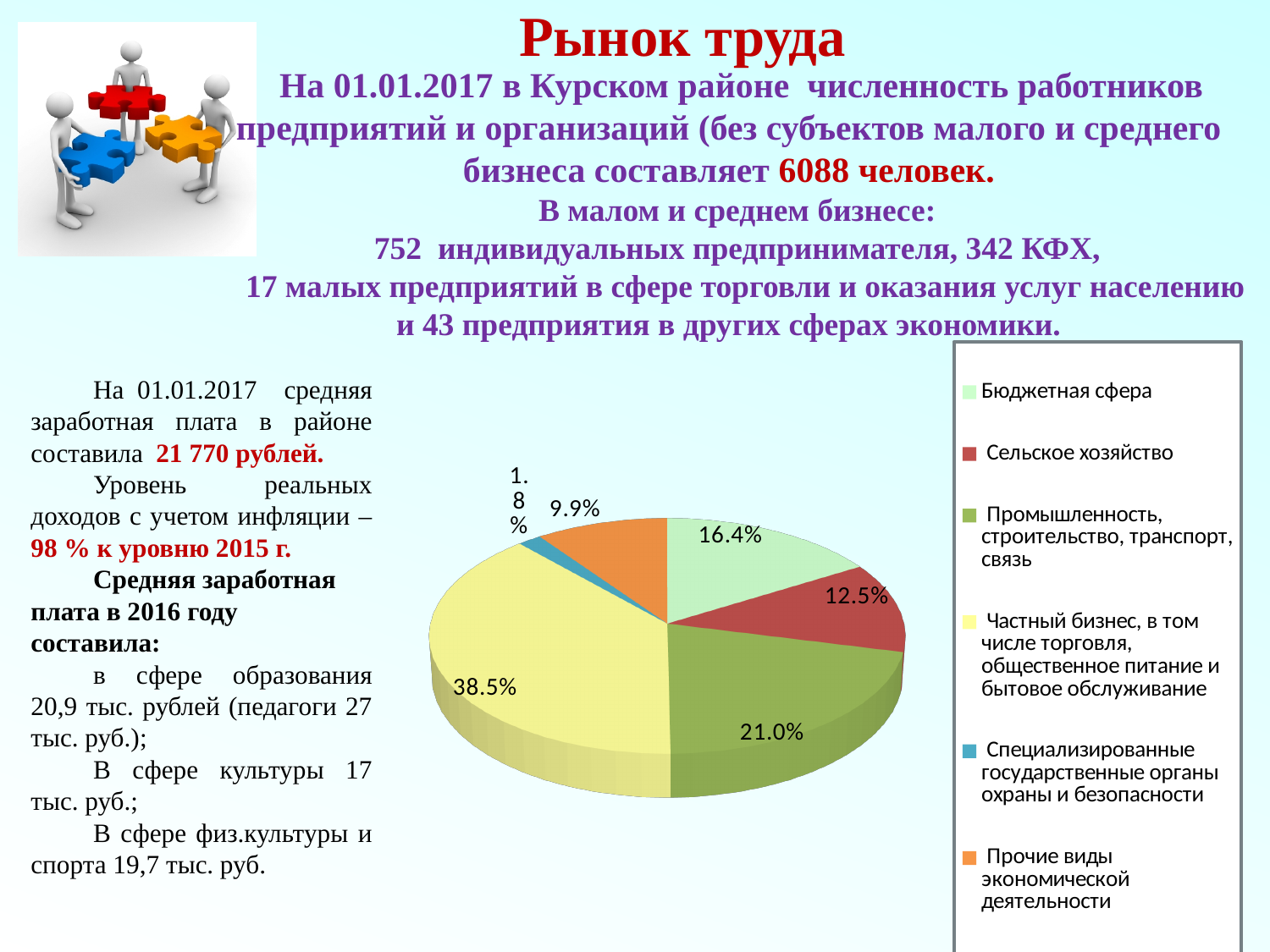
Which category has the smallest slice of the pie? Специализированные государственные органы охраны и безопасности Which is larger: the share of "Бюджетная сфера" or the share of "Сельское хозяйство"? Бюджетная сфера What share of the pie does "Бюджетная сфера" have? 16.4% What is the difference between the shares of "Частный бизнес" and "Промышленность, строительство, транспорт, связь"? 17.5% How many slices does the pie chart have? 6 What share of the pie does "Прочие виды экономической деятельности" have? 9.9% Which category has the largest slice of the pie? Частный бизнес, в том числе торговля, общественное питание и бытовое обслуживание What share of the pie does "Сельское хозяйство" have? 12.5% What share of the pie does "Промышленность, строительство, транспорт, связь" have? 21.0% What kind of chart is shown on the slide? pie chart How many entries does the legend of the pie chart list? 6 What colour is the slice for "Частный бизнес, в том числе торговля, общественное питание и бытовое обслуживание"? yellow